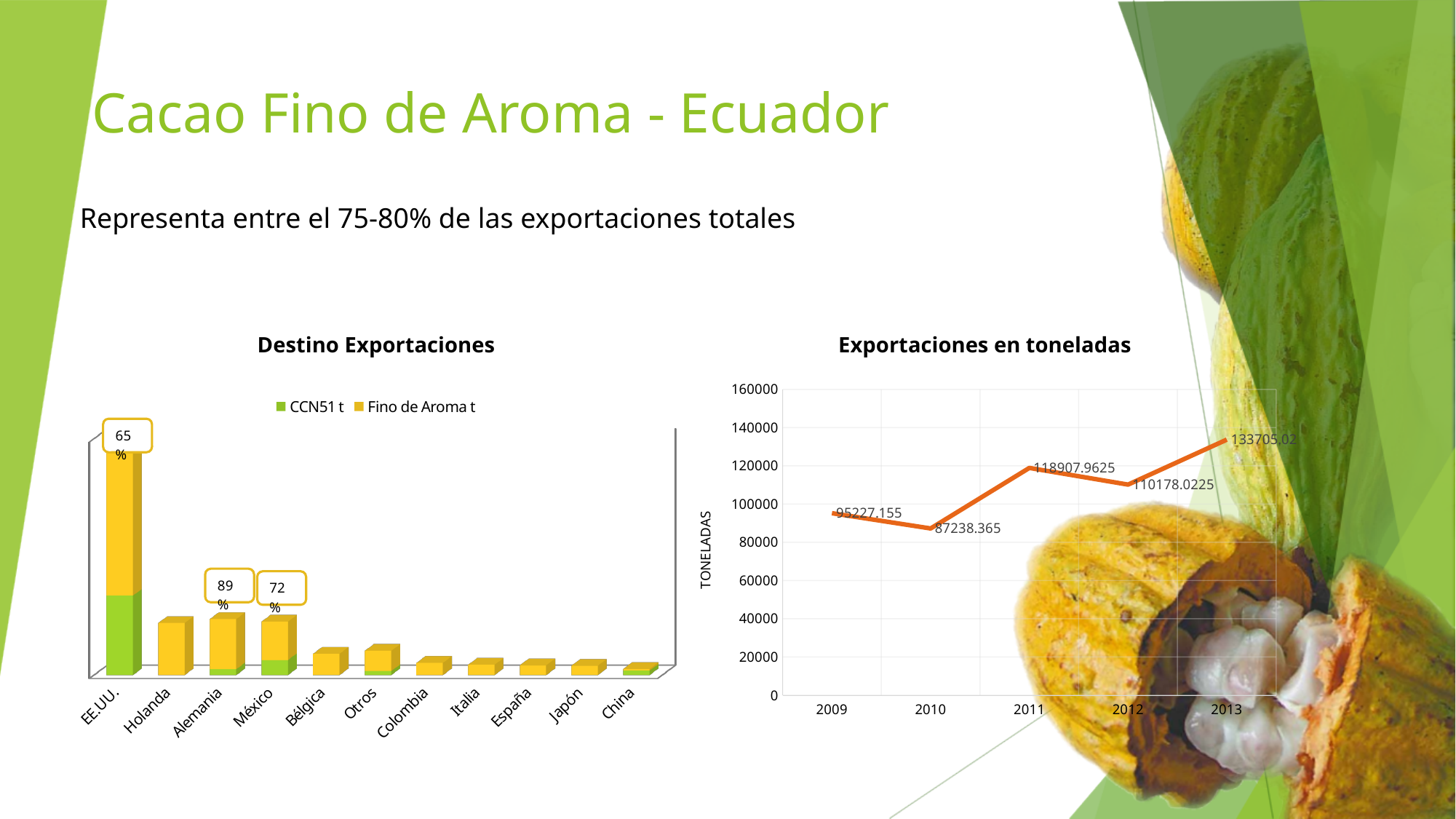
In the 'Exportaciones en toneladas' chart, is the value for 2011 greater or less than 100000? greater In the 'Destino Exportaciones' chart, which destination has the tallest bar? EE.UU. What kind of chart is 'Destino Exportaciones'? bar chart How many series does the legend of the 'Destino Exportaciones' chart list? 2 In the 'Exportaciones en toneladas' chart, which year has the lowest value? 2010 In the 'Exportaciones en toneladas' chart, what is the value for 2010? 87238.365 In the 'Exportaciones en toneladas' chart, do the values rise or fall from 2009 to 2010? fall In the 'Exportaciones en toneladas' chart, what is the value for 2011? 118907.9625 In the 'Exportaciones en toneladas' chart, what is the value for 2013? 133705.02 In the 'Exportaciones en toneladas' chart, which year has the highest value? 2013 In the 'Exportaciones en toneladas' chart, what is the difference between the 2013 value and the 2012 value? 23526.9975 How many years are plotted in the 'Exportaciones en toneladas' chart? 5